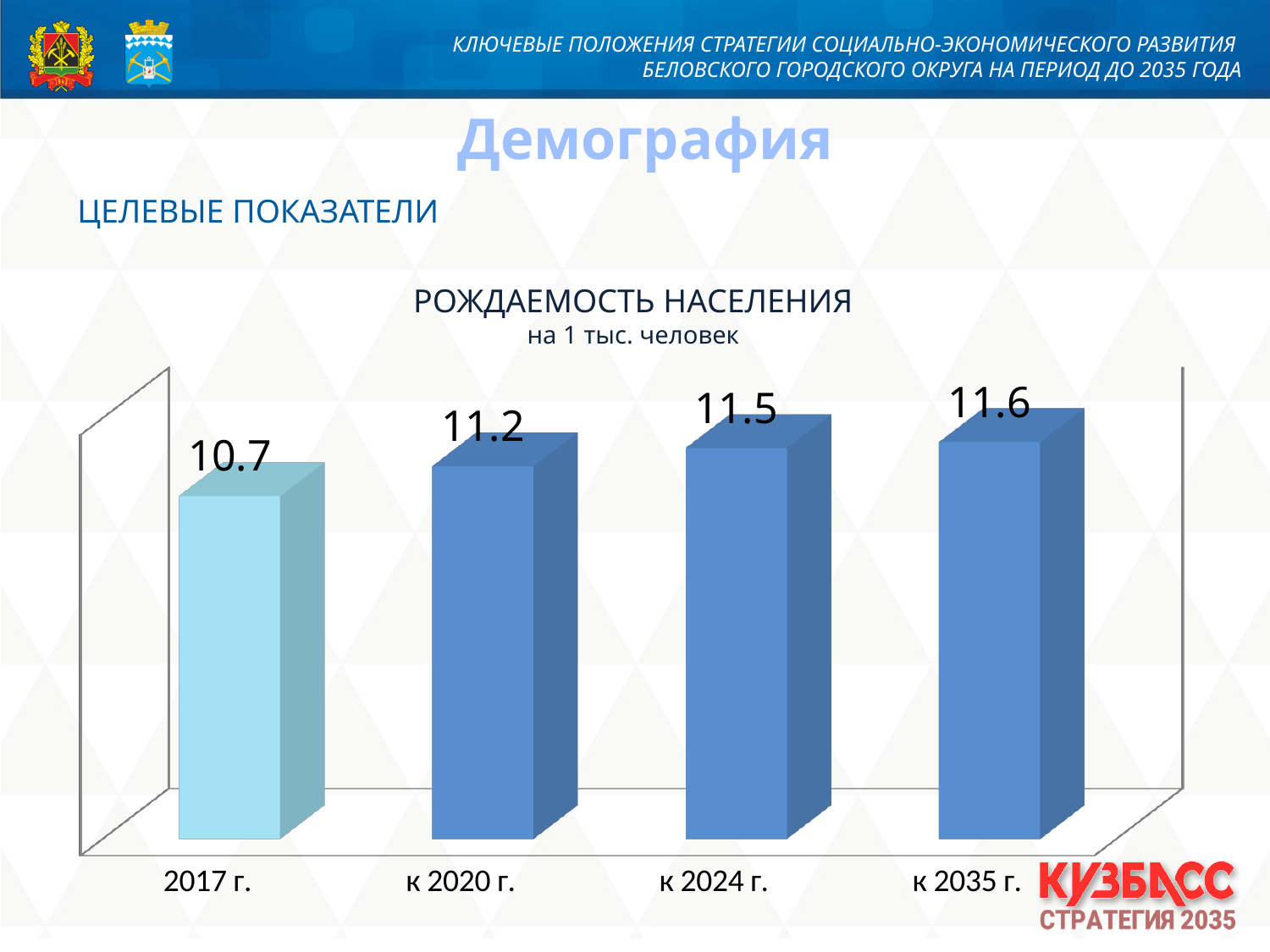
What is the difference between the birth rate values for к 2024 г. and к 2020 г.? 0.3 Do the values rise or fall from 2017 г. to к 2035 г.? rise What is the birth rate value shown for к 2020 г.? 11.2 How many categories are shown on the chart? 4 What is the birth rate value shown for к 2024 г.? 11.5 What is the difference between the birth rate values for к 2035 г. and 2017 г.? 0.9 Which category has the highest birth rate value? к 2035 г. What is the birth rate value shown for 2017 г.? 10.7 Which category has the lowest birth rate value? 2017 г. What is the birth rate value shown for к 2035 г.? 11.6 What kind of chart is shown on the slide? bar chart Which is larger, the value for 2017 г. or the value for к 2020 г.? к 2020 г.